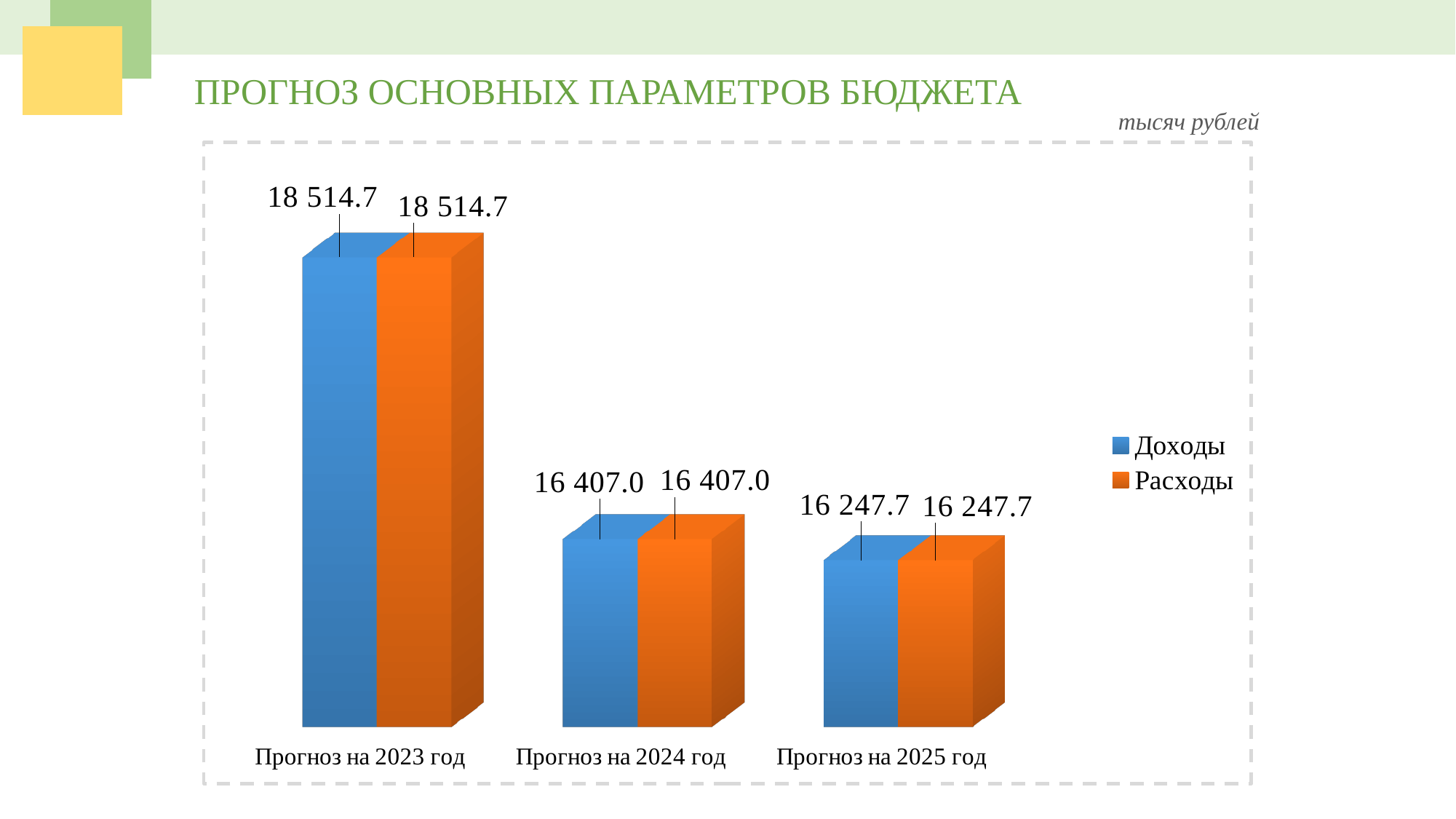
Which is larger: Доходы for Прогноз на 2023 год or Доходы for Прогноз на 2025 год? Прогноз на 2023 год How many categories are shown on the x axis? 3 What kind of chart is shown on the slide? Bar chart What is the difference between Доходы for Прогноз на 2023 год and Доходы for Прогноз на 2024 год? 2 107.7 What is the difference between Расходы for Прогноз на 2024 год and Расходы for Прогноз на 2025 год? 159.3 What is the value of Доходы for Прогноз на 2023 год? 18 514.7 Which year has the highest Доходы value? Прогноз на 2023 год Do the Доходы values rise or fall from Прогноз на 2023 год to Прогноз на 2025 год? Fall What is the value of Доходы for Прогноз на 2025 год? 16 247.7 How many series does the legend list? 2 Which year has the lowest Расходы value? Прогноз на 2025 год What is the value of Расходы for Прогноз на 2024 год? 16 407.0